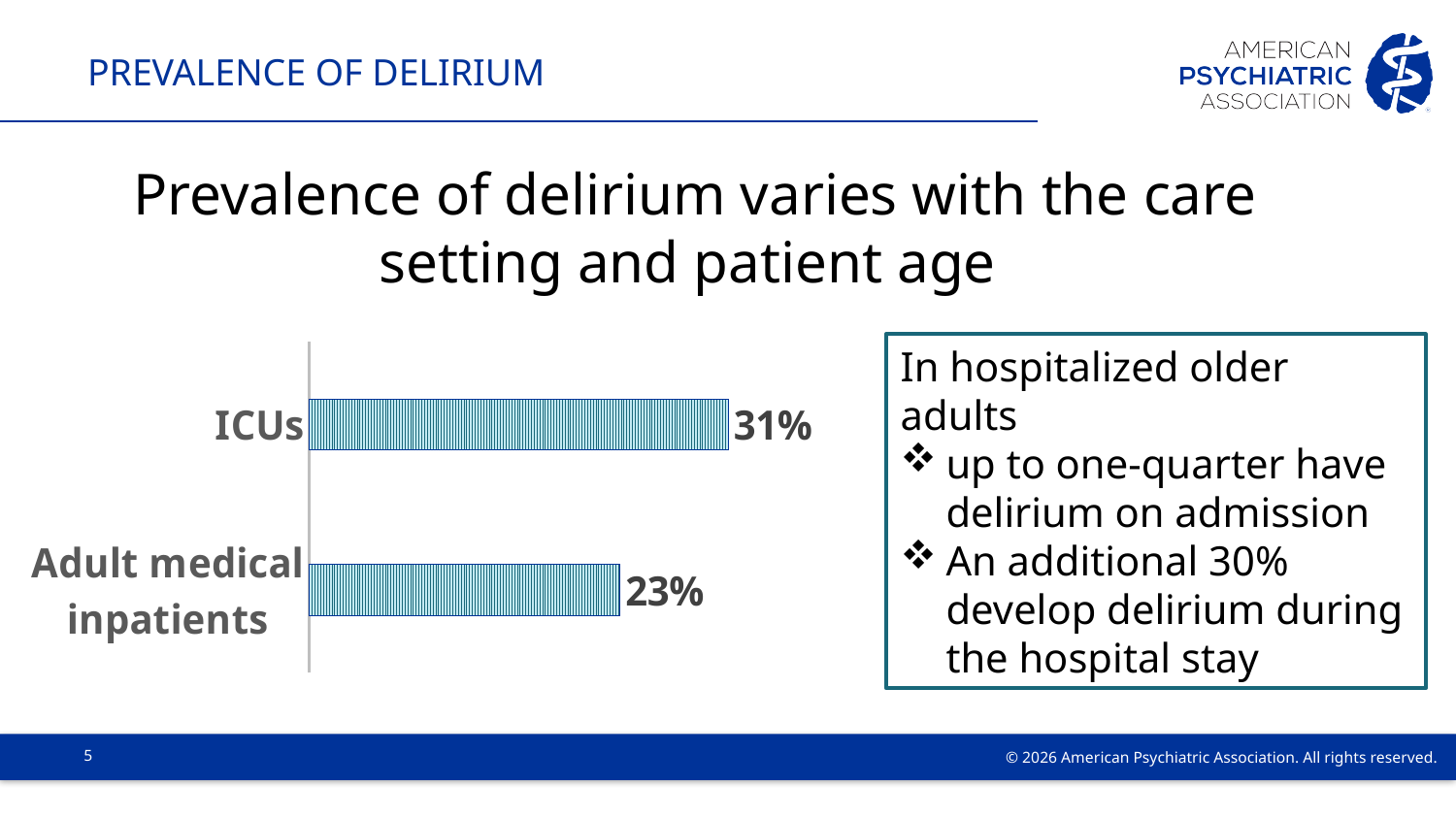
What is the difference in prevalence between ICUs and adult medical inpatients? 8% What is the prevalence of delirium among adult medical inpatients? 23% What is the title of the slide above the chart? Prevalence of delirium varies with the care setting and patient age Which category has the lowest prevalence of delirium? Adult medical inpatients Are the bars in the chart horizontal or vertical? Horizontal What kind of chart is shown on the slide? Bar chart Which category has the highest prevalence of delirium? ICUs Which is larger, the prevalence for ICUs or for adult medical inpatients? ICUs How many categories are shown in the chart? 2 What is the prevalence of delirium in ICUs? 31%